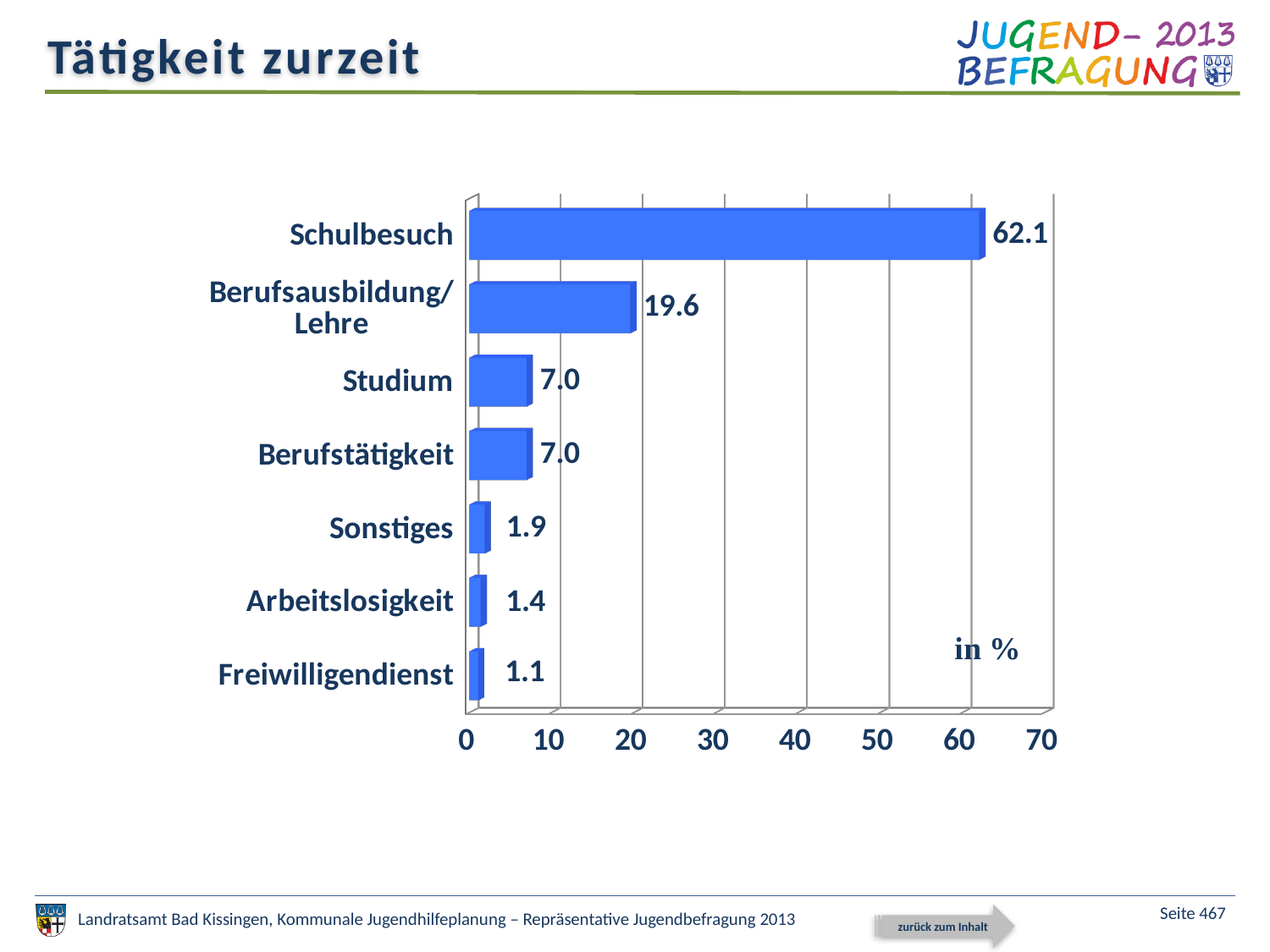
What kind of chart is shown on the slide? bar chart Is the value for Schulbesuch greater or less than 60? greater What is the title of the slide? Tätigkeit zurzeit What is the value for Schulbesuch? 62.1 Which is larger, the value for Sonstiges or the value for Arbeitslosigkeit? Sonstiges How many categories are shown in the chart? 7 What is the value for Arbeitslosigkeit? 1.4 Which category has the lowest value? Freiwilligendienst What is the difference between the values for Schulbesuch and Berufsausbildung/Lehre? 42.5 What is the value for Freiwilligendienst? 1.1 What is the value for Berufsausbildung/Lehre? 19.6 Which category has the highest value? Schulbesuch